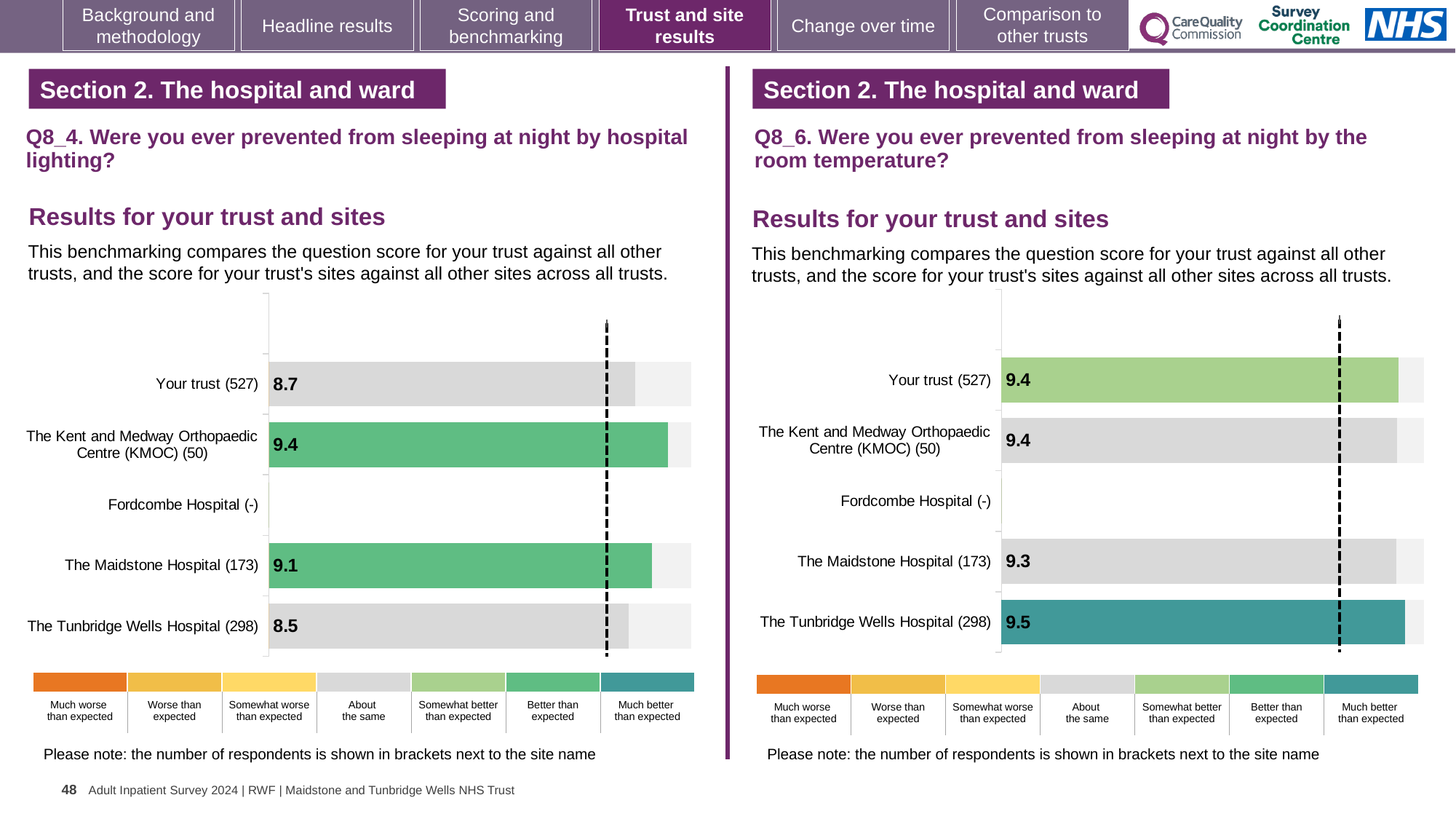
In the Q8_4 hospital lighting chart, what is the score for Your trust (527)? 8.7 What type of chart is used for the Q8_6 room temperature results? Bar chart In the Q8_4 hospital lighting chart, which site has the highest score? The Kent and Medway Orthopaedic Centre (KMOC) (50) In the Q8_6 room temperature chart, which is larger: the score for Your trust or the score for The Maidstone Hospital? Your trust In the Q8_4 hospital lighting chart, which site has no score shown? Fordcombe Hospital (-) In the Q8_4 hospital lighting chart, which site has the lowest score? The Tunbridge Wells Hospital (298) In the Q8_6 room temperature chart, what is the difference between the scores for The Tunbridge Wells Hospital and The Maidstone Hospital? 0.2 In the Q8_6 room temperature chart, which site has the highest score? The Tunbridge Wells Hospital (298) In the Q8_6 room temperature chart, what is the score for The Maidstone Hospital (173)? 9.3 In the Q8_4 hospital lighting chart, what is the difference between the scores for The Kent and Medway Orthopaedic Centre (KMOC) and The Maidstone Hospital? 0.3 In the Q8_4 hospital lighting chart, what is the score for The Tunbridge Wells Hospital (298)? 8.5 How many sites are listed on the vertical axis of the Q8_4 hospital lighting chart? 5